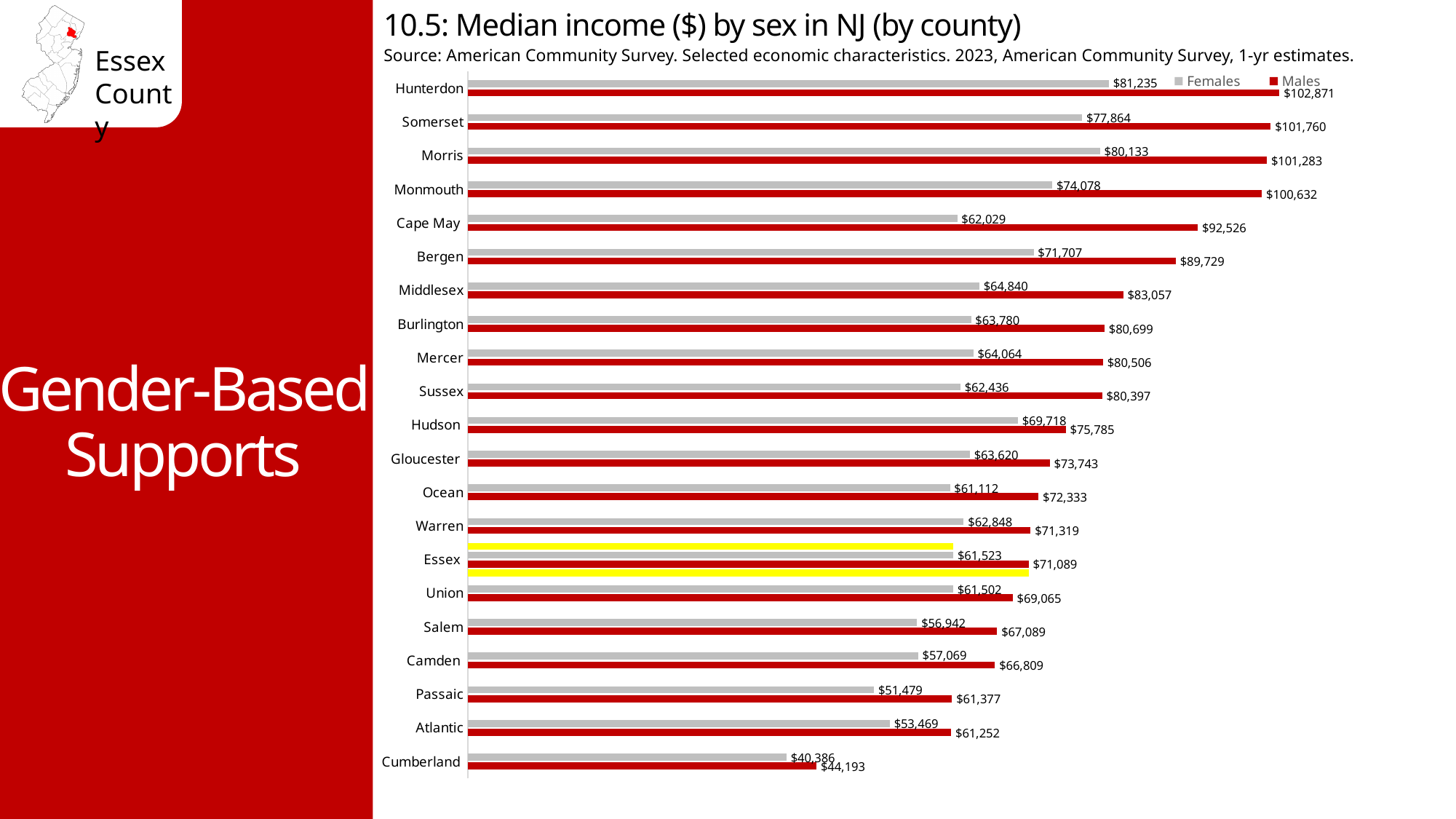
Which is larger, the female median income in Hudson County or in Bergen County? Bergen County What is the difference between male and female median income in Hunterdon County? $21,636 Which county has the lowest median income for females? Cumberland What is the median income for females in Hunterdon County? $81,235 What is the difference between male and female median income in Essex County? $9,566 What is the median income for females in Essex County? $61,523 What type of chart is used to show median income by sex? Bar chart What is the median income for males in Essex County? $71,089 How many counties are shown in the chart? 21 What is the median income for males in Cumberland County? $44,193 How many series does the legend list? 2 Which county has the highest median income for males? Hunterdon